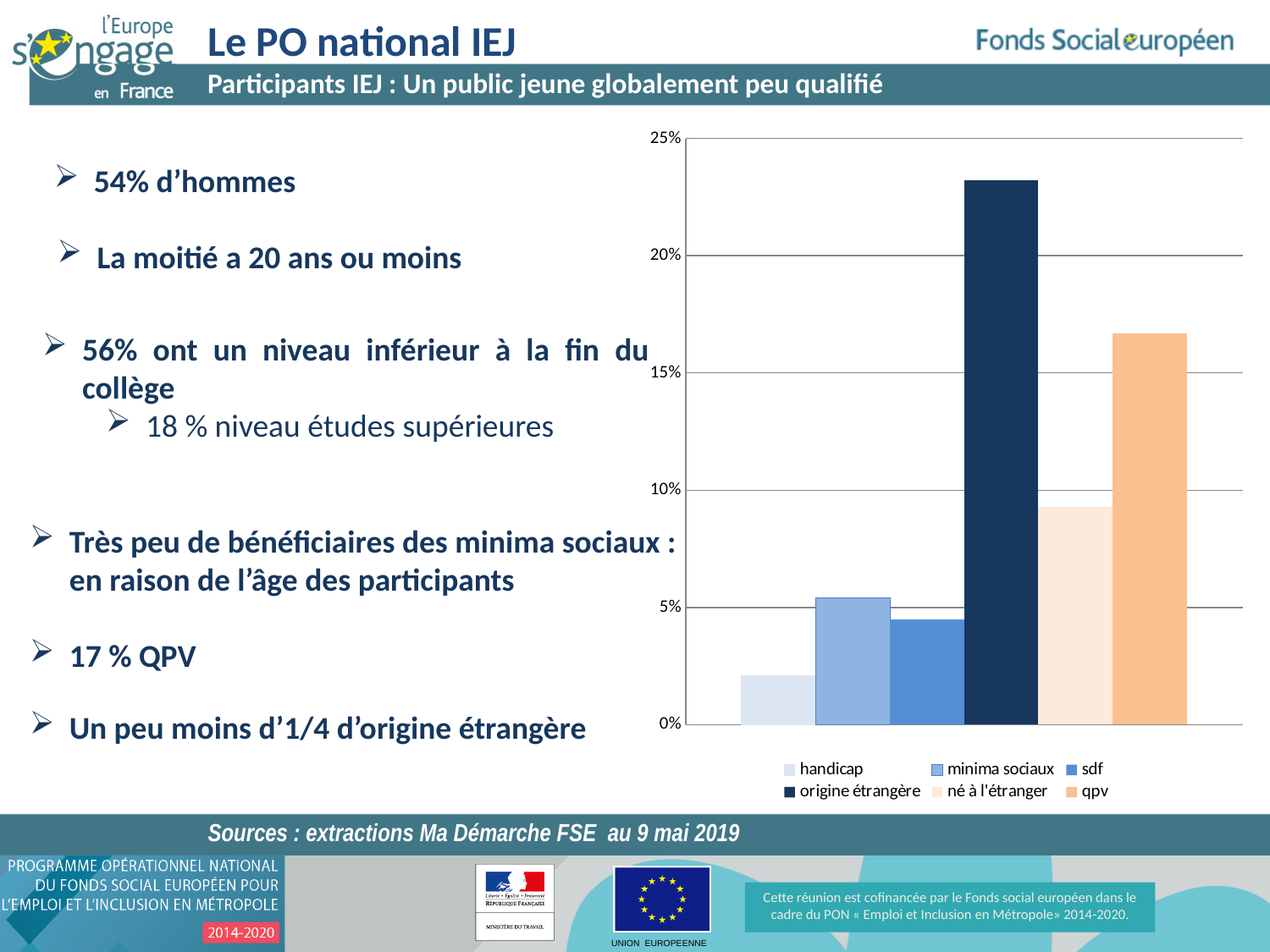
Is the value for né à l'étranger greater or less than 10%? less Is the value for qpv greater or less than 15%? greater Is the value for origine étrangère greater or less than 20%? greater How many series does the chart legend list? 6 Which series has the highest bar in the chart? origine étrangère What is the highest value shown on the chart's vertical axis? 25% Which is larger, the value for qpv or the value for né à l'étranger? qpv What kind of chart is shown on the slide? bar chart How many bars are plotted in the chart? 6 Which is larger, the value for sdf or the value for handicap? sdf Which series has the lowest bar in the chart? handicap